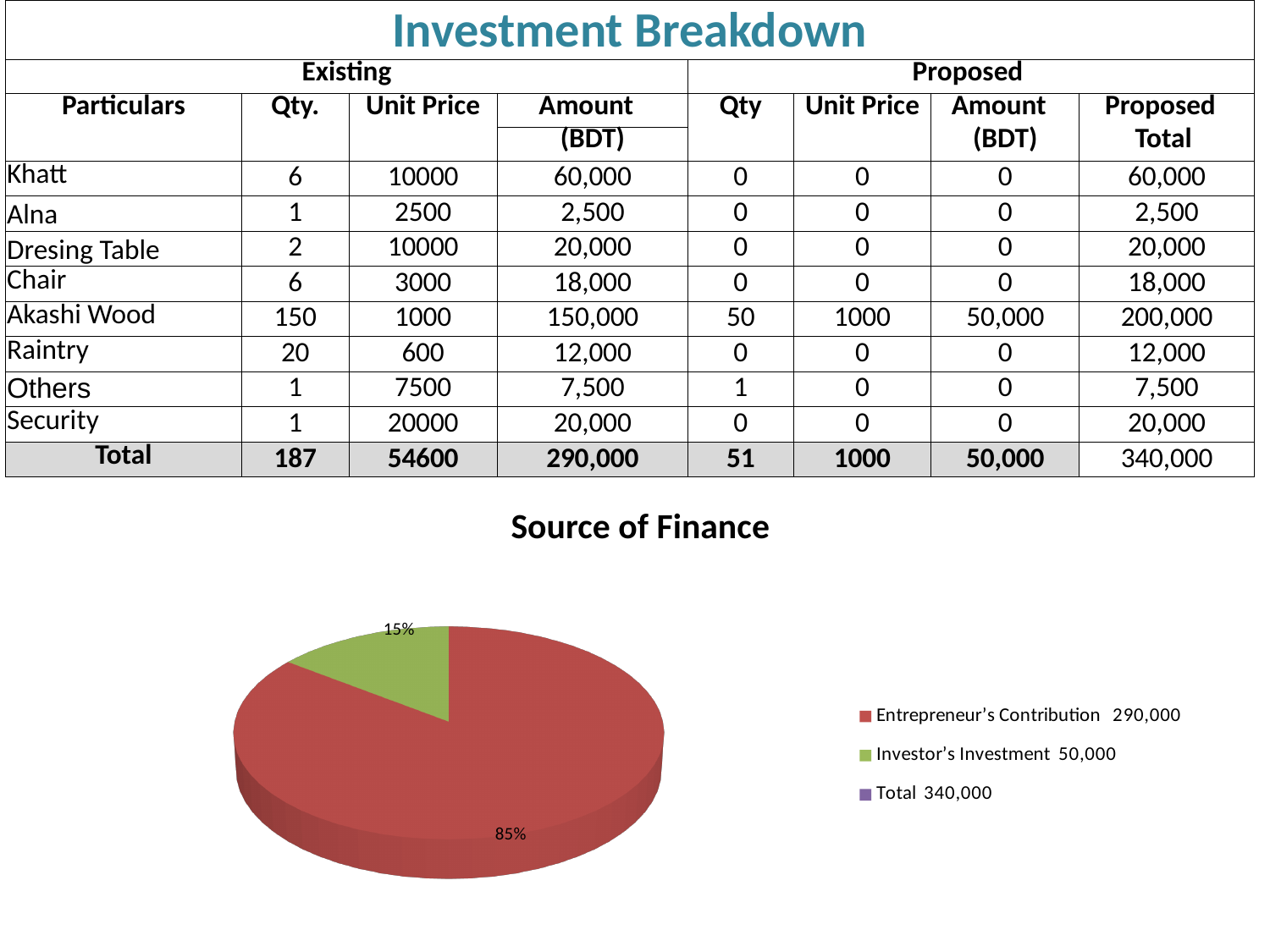
In the Source of Finance pie chart, which source has the largest slice? Entrepreneur's Contribution In the Source of Finance pie chart, what is the difference between the Entrepreneur's Contribution and the Investor's Investment amounts shown in the legend? 240,000 In the Source of Finance pie chart, what amount does the legend give for Entrepreneur's Contribution? 290,000 In the Source of Finance pie chart, what amount does the legend give for Investor's Investment? 50,000 In the Source of Finance pie chart, which is larger: Entrepreneur's Contribution or Investor's Investment? Entrepreneur's Contribution In the Source of Finance pie chart, what percentage share is labelled on the green slice? 15% In the Source of Finance pie chart, which source has the smallest slice? Investor's Investment What kind of chart is shown under the title "Source of Finance"? pie chart In the Source of Finance pie chart, what percentage share is labelled on the red slice? 85% How many entries does the legend of the Source of Finance pie chart list? 3 In the Source of Finance pie chart, what colour is the Investor's Investment slice? green In the Source of Finance pie chart, what amount does the legend give for Total? 340,000